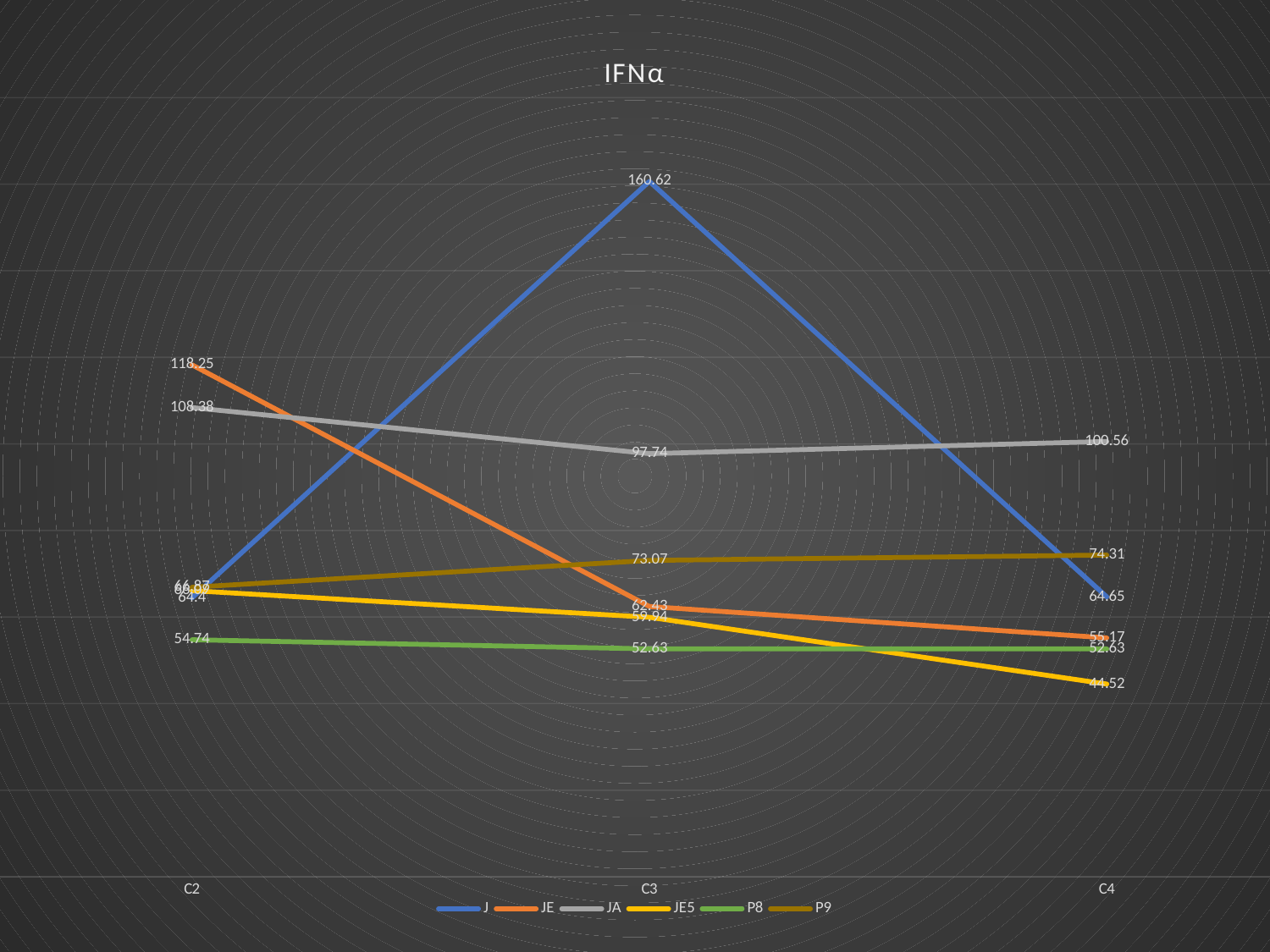
What is the value of series JA at C4? 100.56 What is the value of series J at C3? 160.62 What is the value of series P8 at C2? 54.74 At C4, which series has the larger value, JA or JE? JA What is the difference between the JA values at C2 and C3? 10.64 What is the value of series JE at C2? 118.25 Which series has the lowest value at C4? JE5 How many series does the legend list? 6 What is the value of series JE5 at C4? 44.52 What kind of chart is shown on the slide? Line chart Which series has the highest value at C3? J Does the P9 series rise or fall from C3 to C4? Rise